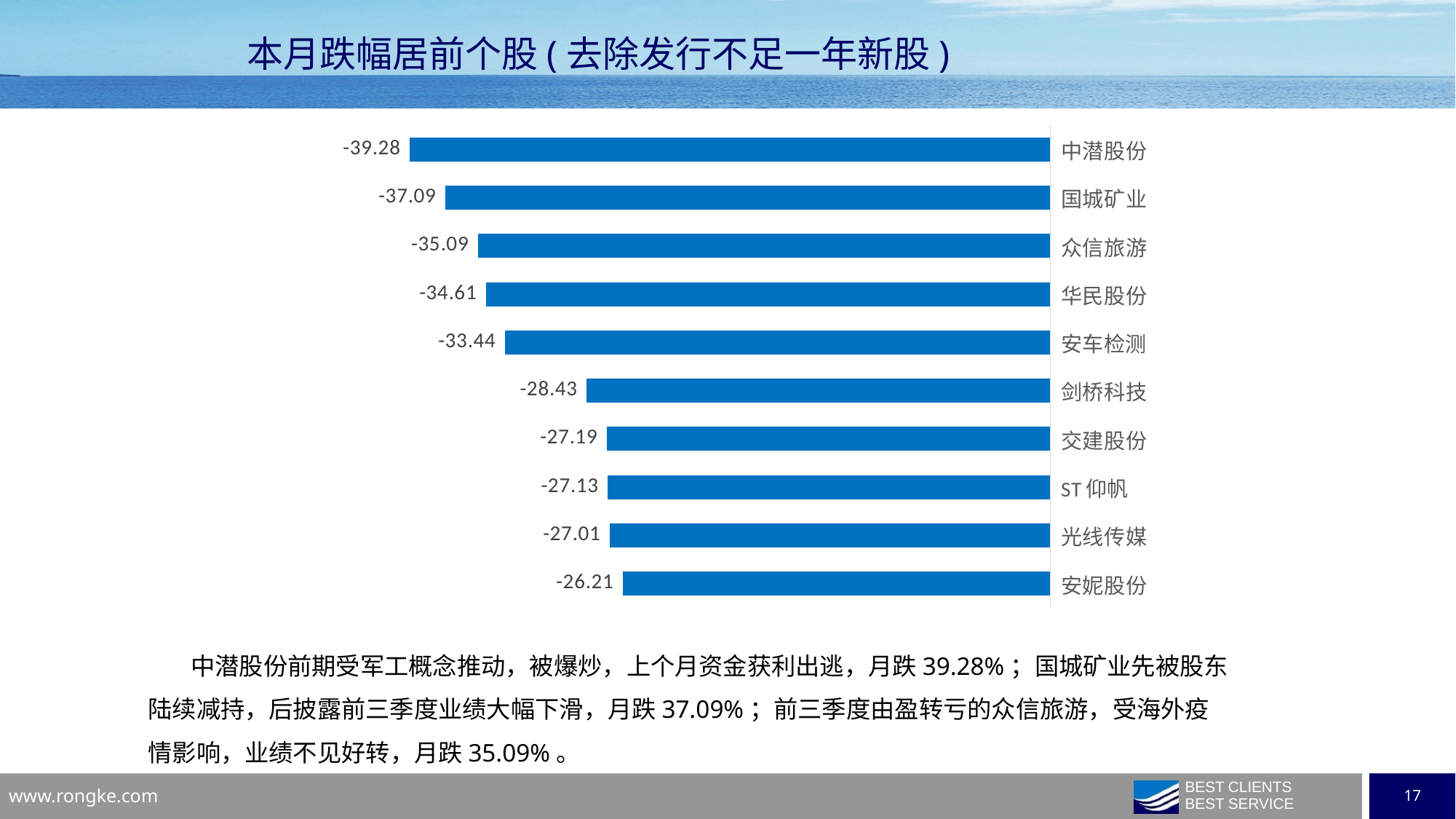
What is the difference between the values for 剑桥科技 and 安妮股份? 2.22 What is the value shown for 光线传媒? -27.01 What is the difference between the values for 中潜股份 and 国城矿业? 2.19 What kind of chart is shown on the slide? Bar chart Which stock fell more this month, 华民股份 or 交建股份? 华民股份 What is the value shown for 中潜股份? -39.28 Which stock has the largest decline (the most negative value) in the chart? 中潜股份 How many stocks are shown in the chart? 10 What is the value shown for 众信旅游? -35.09 What is the value shown for 安车检测? -33.44 What is the title of the slide containing the chart? 本月跌幅居前个股(去除发行不足一年新股) Which stock has the smallest decline (the least negative value) in the chart? 安妮股份